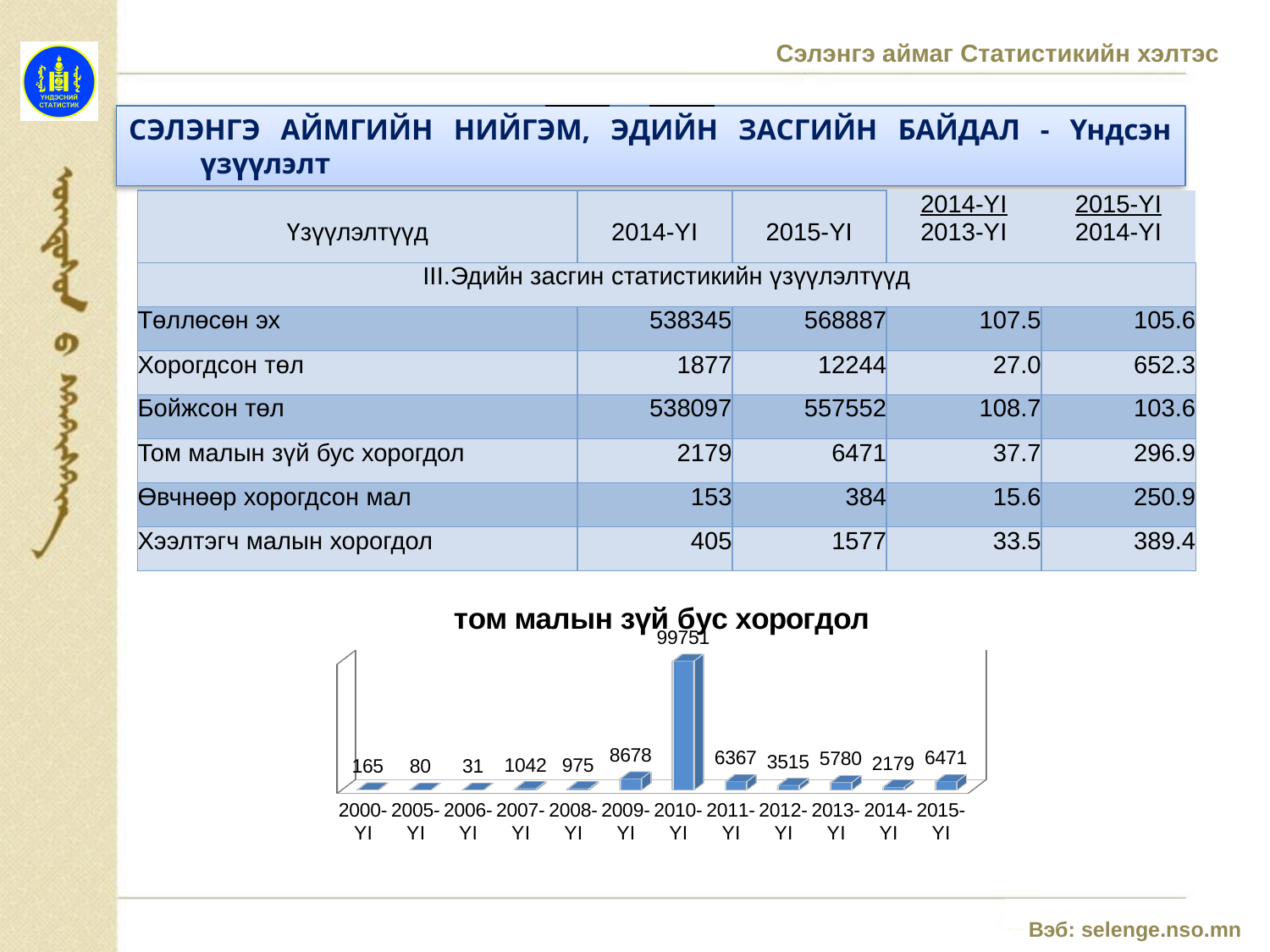
Do the values rise or fall from 2013-YI to 2014-YI? fall Which category has the lowest value in the chart? 2006-YI Which is larger, the value for 2011-YI or the value for 2012-YI? 2011-YI What is the value for 2007-YI in the chart? 1042 Which category has the highest value in the chart? 2010-YI What is the difference between the values for 2015-YI and 2014-YI? 4292 How many categories are shown on the x axis of the chart? 12 What is the value for 2009-YI in the chart? 8678 What kind of chart is shown on the slide? bar chart What is the value for 2010-YI in the chart? 99751 What is the value for 2015-YI in the chart? 6471 What is the title of the chart? том малын зүй бус хорогдол